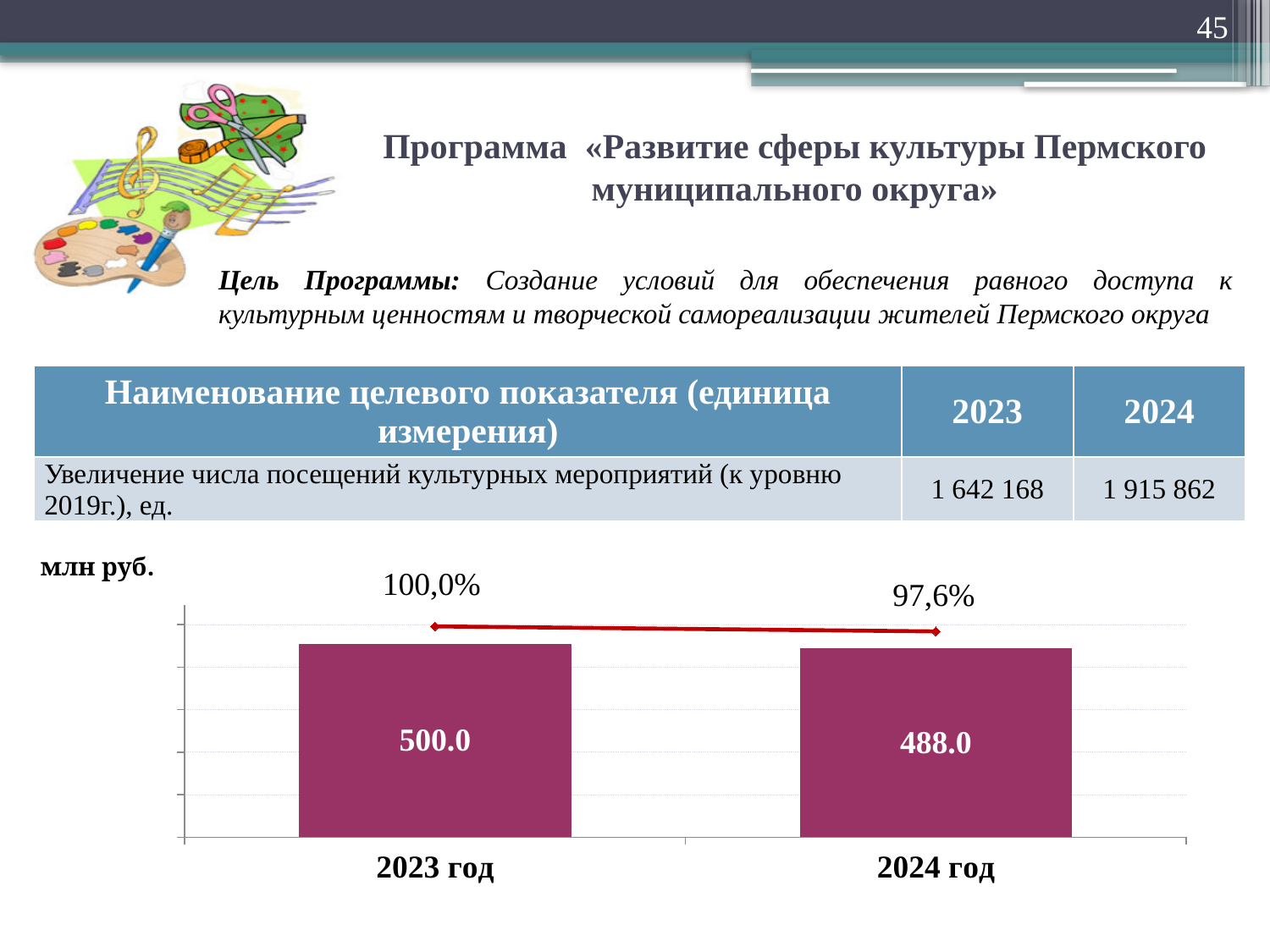
Which year has the lower bar in the chart? 2024 год What percentage label is shown above the 2024 год bar on the line? 97,6% What percentage label is shown above the 2023 год bar on the line? 100,0% Which year has the higher bar in the chart? 2023 год What is the value for 2024 год in the bar chart? 488.0 How many bars are shown in the chart? 2 What kind of chart is shown on the slide? combination bar and line chart What unit of measurement is indicated for the chart? млн руб. What is the value for 2023 год in the bar chart? 500.0 Is the bar for 2023 год larger or smaller than the bar for 2024 год? larger What is the difference between the bar values for 2023 год and 2024 год? 12.0 Do the bar values rise or fall from 2023 год to 2024 год? fall